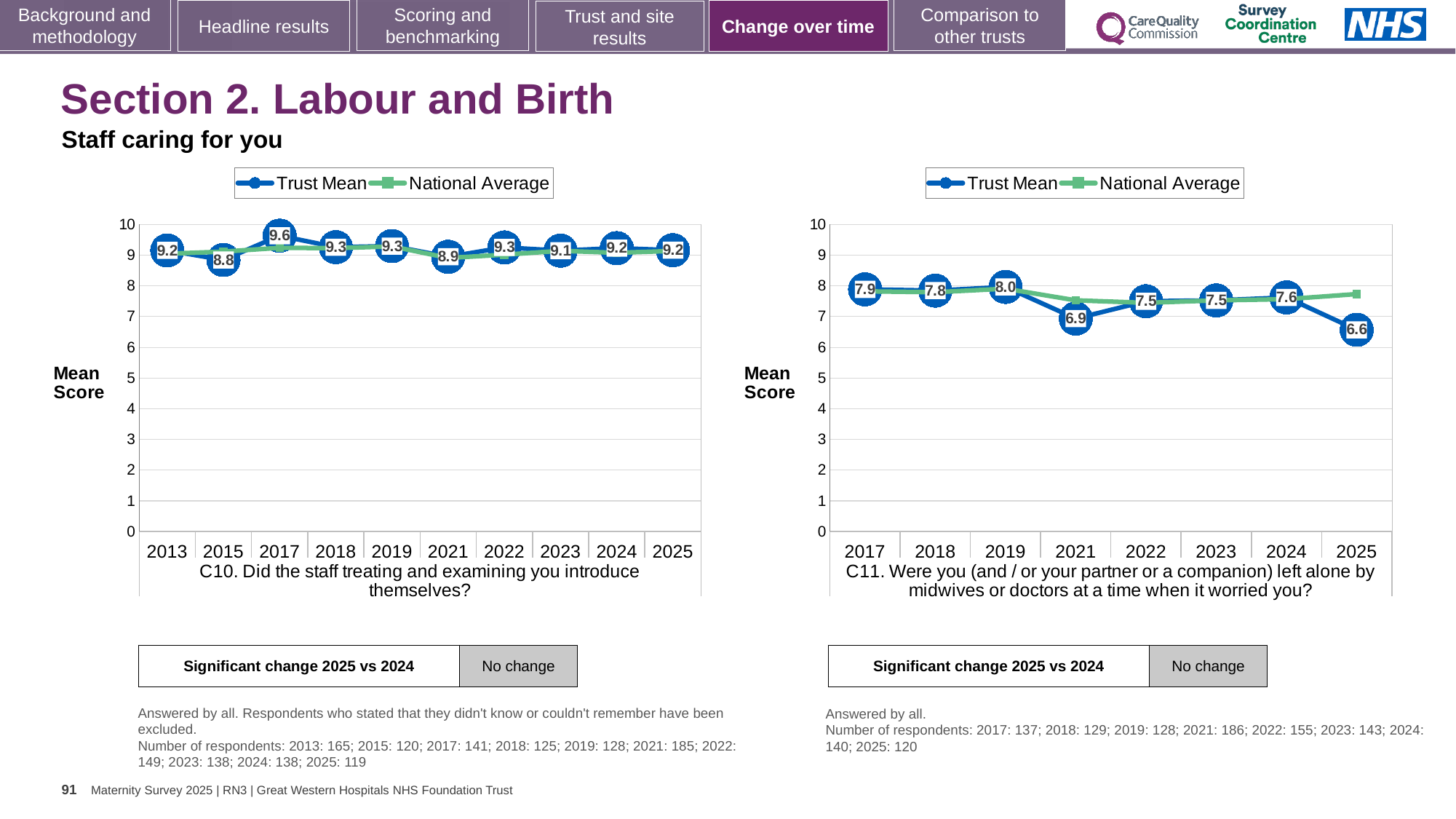
In the left chart (C10), how many years are plotted on the x axis? 10 In the left chart (C10), which year has the lowest Trust Mean? 2015 In the right chart (C11), is the Trust Mean for 2024 larger or smaller than the Trust Mean for 2025? larger In the right chart (C11), what is the Trust Mean for 2025? 6.6 In the left chart (C10), what is the Trust Mean for 2017? 9.6 In the right chart (C11), which year has the lowest Trust Mean? 2025 In the left chart (C10), what is the difference between the Trust Mean for 2017 and for 2015? 0.8 In the left chart (C10), which year has the highest Trust Mean? 2017 In the left chart (C10), what is the Trust Mean for 2015? 8.8 What kind of chart is the right chart (C11)? line chart In the right chart (C11), what is the Trust Mean for 2019? 8.0 In the right chart (C11), how many series does the legend list? 2